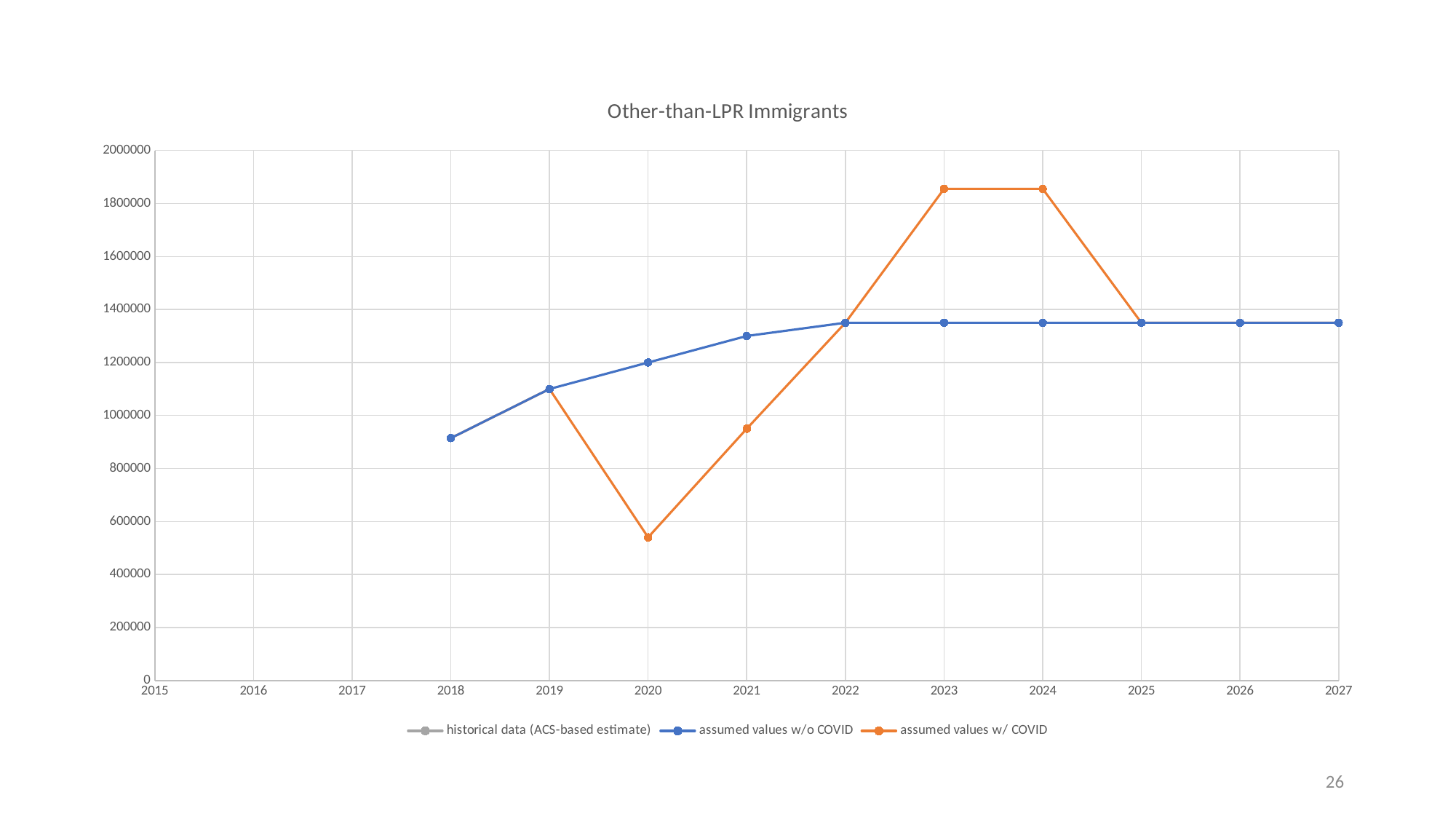
What kind of chart is shown on the slide? line chart Is the value for 'assumed values w/ COVID' in 2023 greater or less than 1800000? greater Does the 'assumed values w/o COVID' series rise or fall from 2018 to 2022? rise How many series does the legend list? 3 Is the value for 'assumed values w/o COVID' in 2018 greater or less than 1000000? less In which year does the 'assumed values w/ COVID' series reach its lowest value? 2020 What is the title of the chart? Other-than-LPR Immigrants Is the value for 'assumed values w/ COVID' in 2020 greater or less than 600000? less In which year does the 'assumed values w/o COVID' series have its lowest value? 2018 Which series is drawn in orange? assumed values w/ COVID In 2024, which series has the larger value: 'assumed values w/o COVID' or 'assumed values w/ COVID'? assumed values w/ COVID In 2021, which series has the larger value: 'assumed values w/o COVID' or 'assumed values w/ COVID'? assumed values w/o COVID